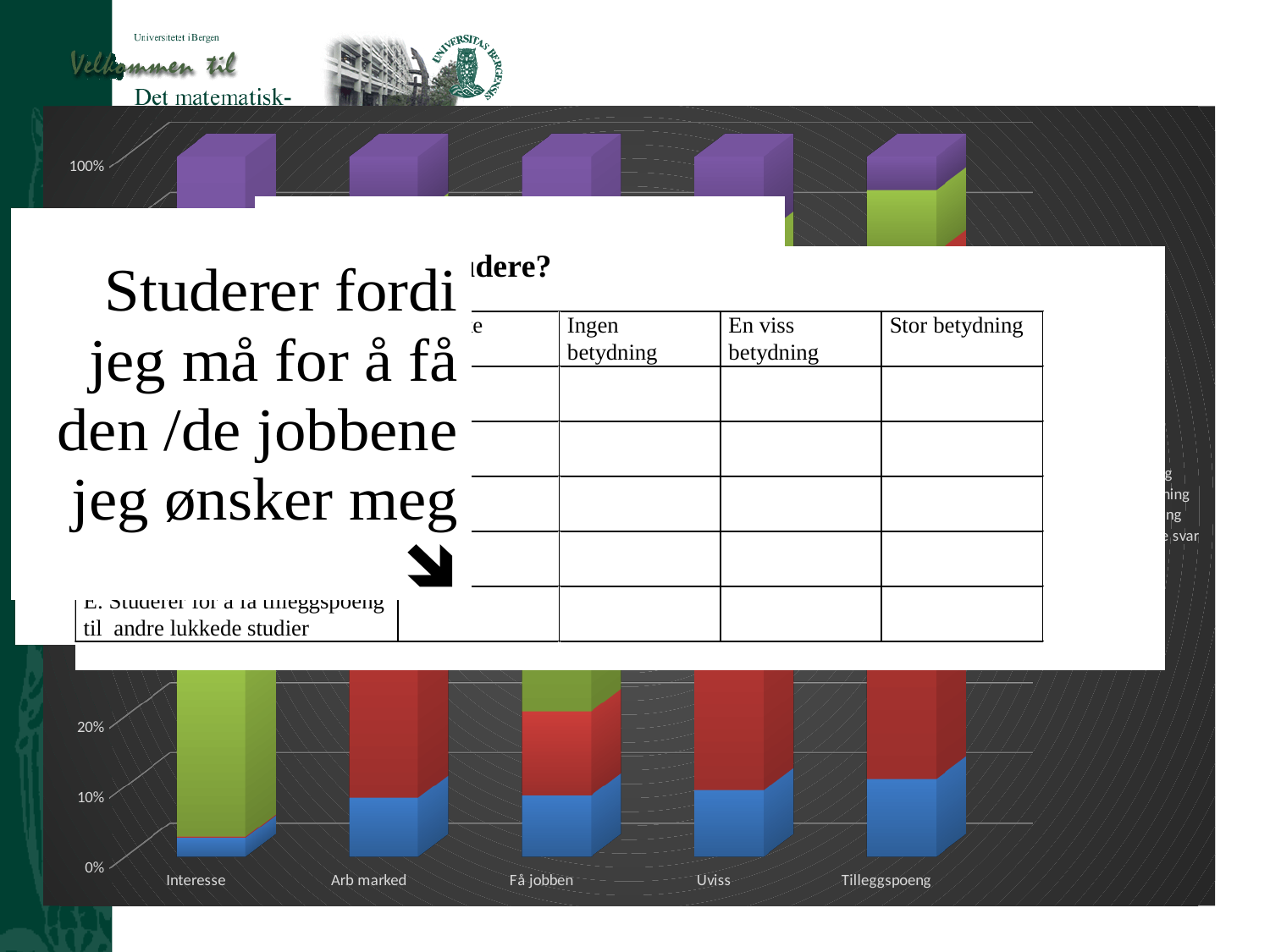
Is the blue (bottom) segment for Tilleggspoeng larger or smaller than the blue segment for Interesse? larger What is the label of the last category on the x axis of the chart? Tilleggspoeng Is the value of the green segment for Interesse greater or less than 20%? greater How many categories are shown on the x axis of the chart? 5 Which category has the smallest blue (bottom) segment in the chart? Interesse What is the highest value shown on the y axis of the chart? 100% Is the value of the red segment for Arb marked greater or less than 10%? greater What is the label of the first category on the x axis of the chart? Interesse What kind of chart is shown on the slide? stacked bar chart Is the value of the blue (bottom) segment for Interesse greater or less than 10%? less